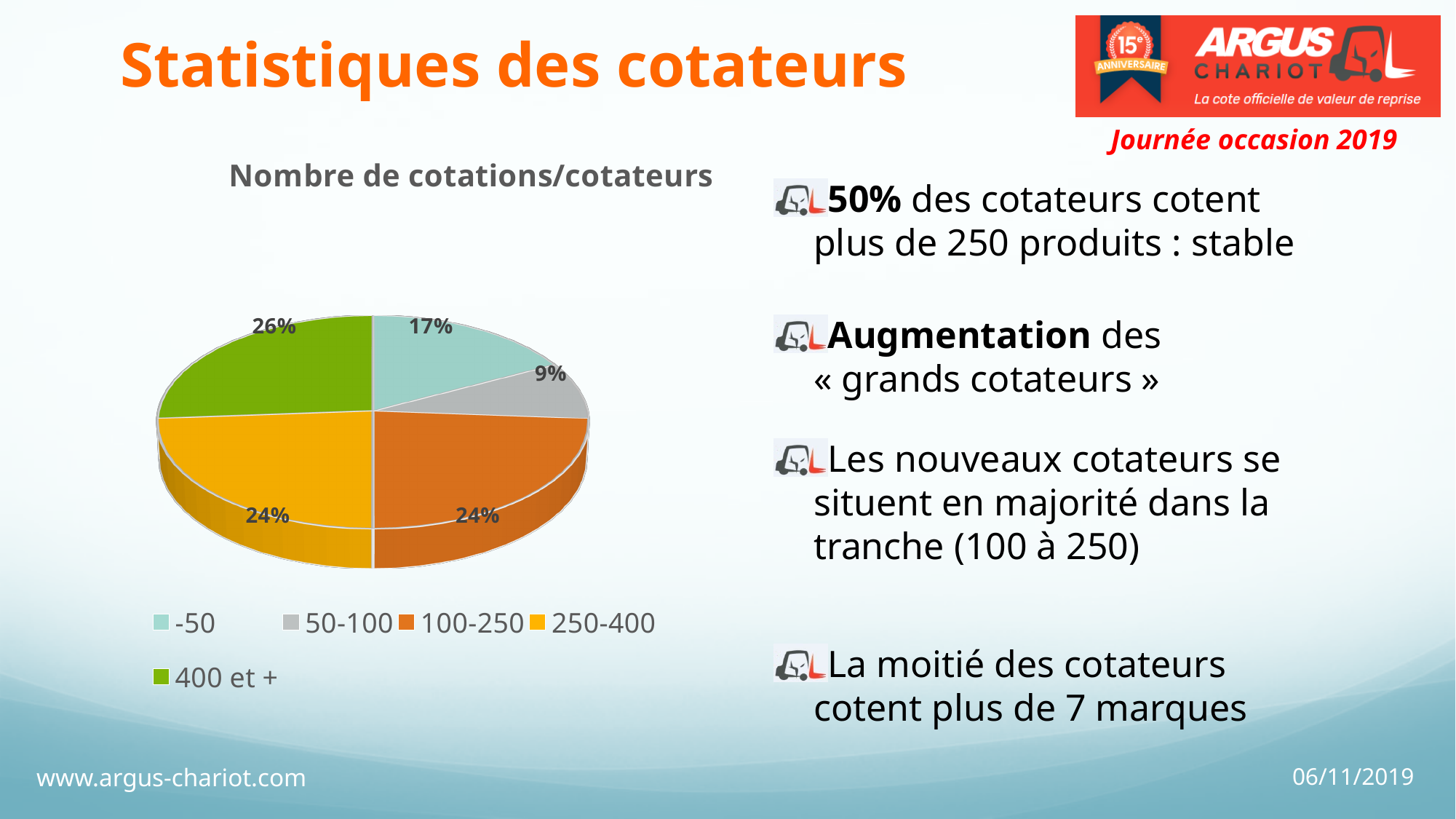
What share of the pie does the "100-250" category have? 24% What is the difference in percentage points between the "-50" slice and the "50-100" slice? 8% What share of the pie does the "-50" category have? 17% What share of the pie does the "50-100" category have? 9% What colour is the "250-400" slice in the pie chart? yellow Which is larger, the "-50" slice or the "400 et +" slice? 400 et + Which category has the largest slice of the pie? 400 et + Which category has the smallest slice of the pie? 50-100 What kind of chart is shown on the slide? pie chart How many categories does the pie chart have? 5 What is the title of the chart? Nombre de cotations/cotateurs